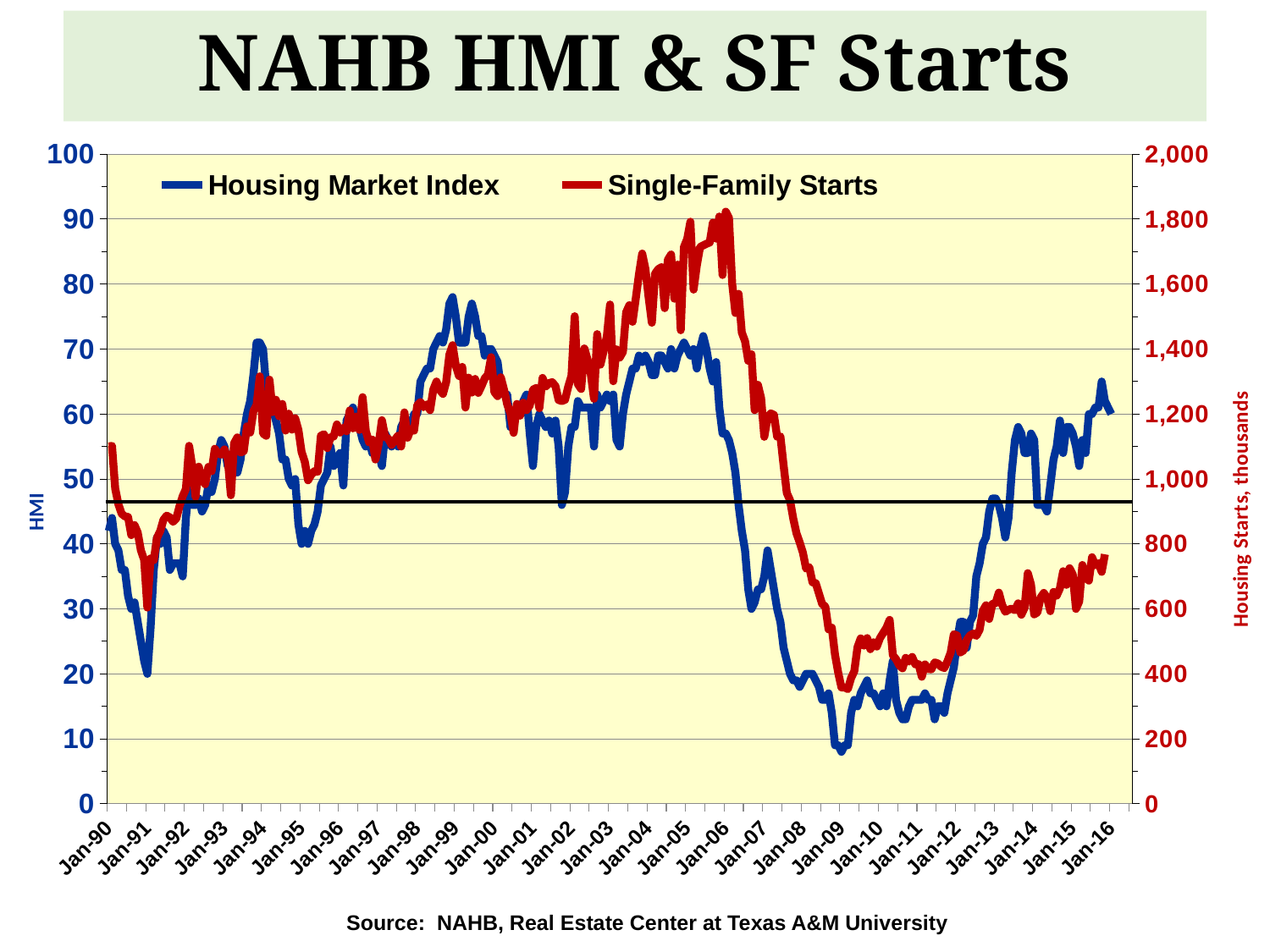
Is the Single-Family Starts value around Jan-06 greater or less than 1,600? greater Do Single-Family Starts rise or fall between Jan-12 and Jan-16? Rise What colour is the Housing Market Index line? Blue Is the Housing Market Index value at Jan-16 greater or less than 50? greater What kind of chart is shown on the slide? Line chart Is the Single-Family Starts value around Jan-11 greater or less than 600? less How many year labels are shown on the x axis? 27 How many series does the legend list? 2 What is the title of the chart? NAHB HMI & SF Starts Does the Housing Market Index rise or fall between Jan-06 and Jan-09? Fall